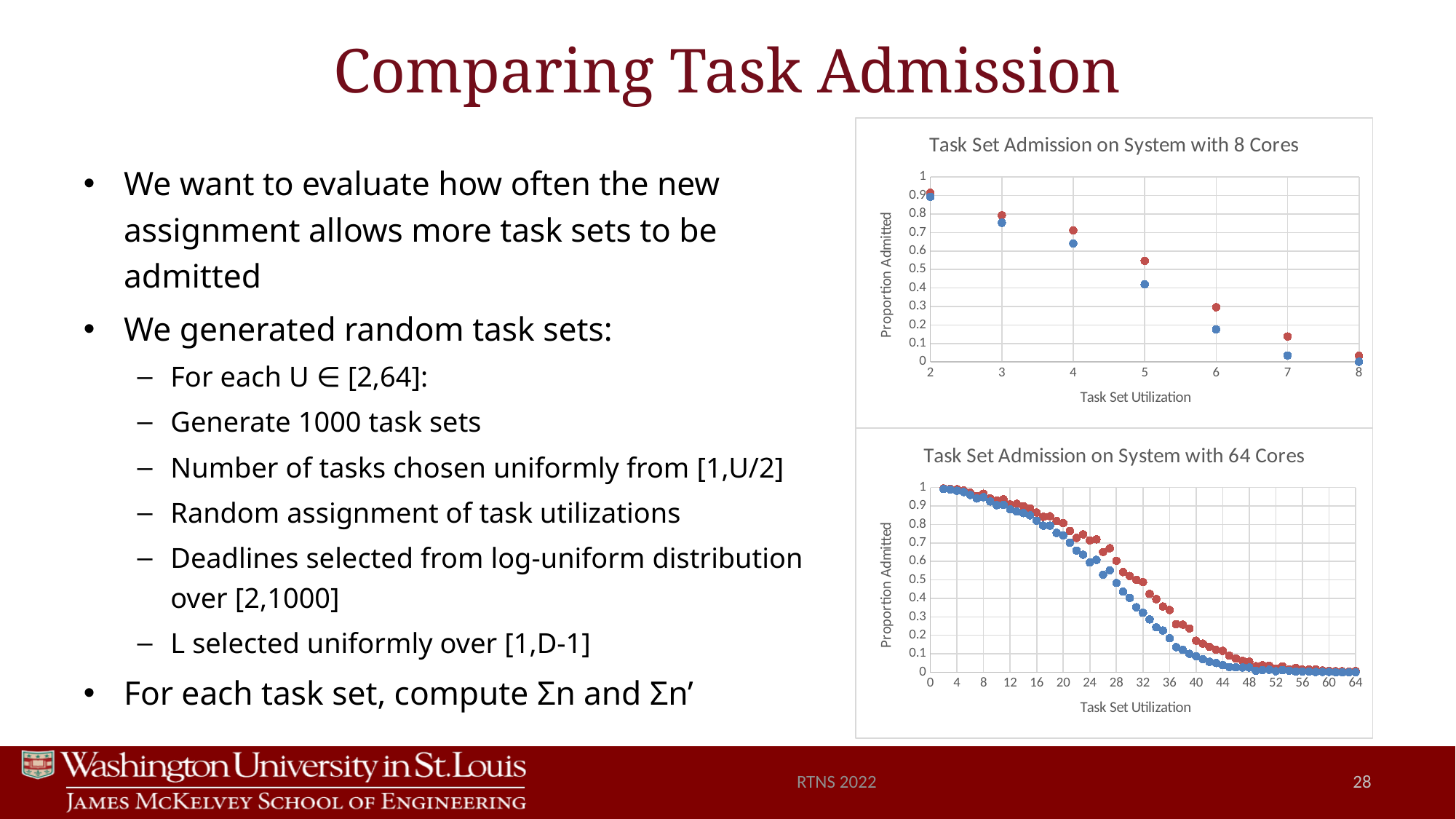
In the 'Task Set Admission on System with 8 Cores' chart, is the blue series value at utilization 7 greater or less than 0.1? less In the 'Task Set Admission on System with 8 Cores' chart, do the plotted values rise or fall as task set utilization increases? fall What kind of chart is the 'Task Set Admission on System with 8 Cores' chart? scatter chart In the 'Task Set Admission on System with 8 Cores' chart, which series has the higher value at utilization 6, the red or the blue? red What is the title of the lower chart on the slide? Task Set Admission on System with 64 Cores In the 'Task Set Admission on System with 8 Cores' chart, is the blue series value at utilization 5 greater or less than 0.5? less In the 'Task Set Admission on System with 64 Cores' chart, is the red series value at utilization 16 greater or less than 0.8? greater In the 'Task Set Admission on System with 8 Cores' chart, how many task set utilization values are plotted for each series? 7 What is the y-axis label of the 'Task Set Admission on System with 64 Cores' chart? Proportion Admitted In the 'Task Set Admission on System with 64 Cores' chart, do the plotted values rise or fall as task set utilization increases? fall